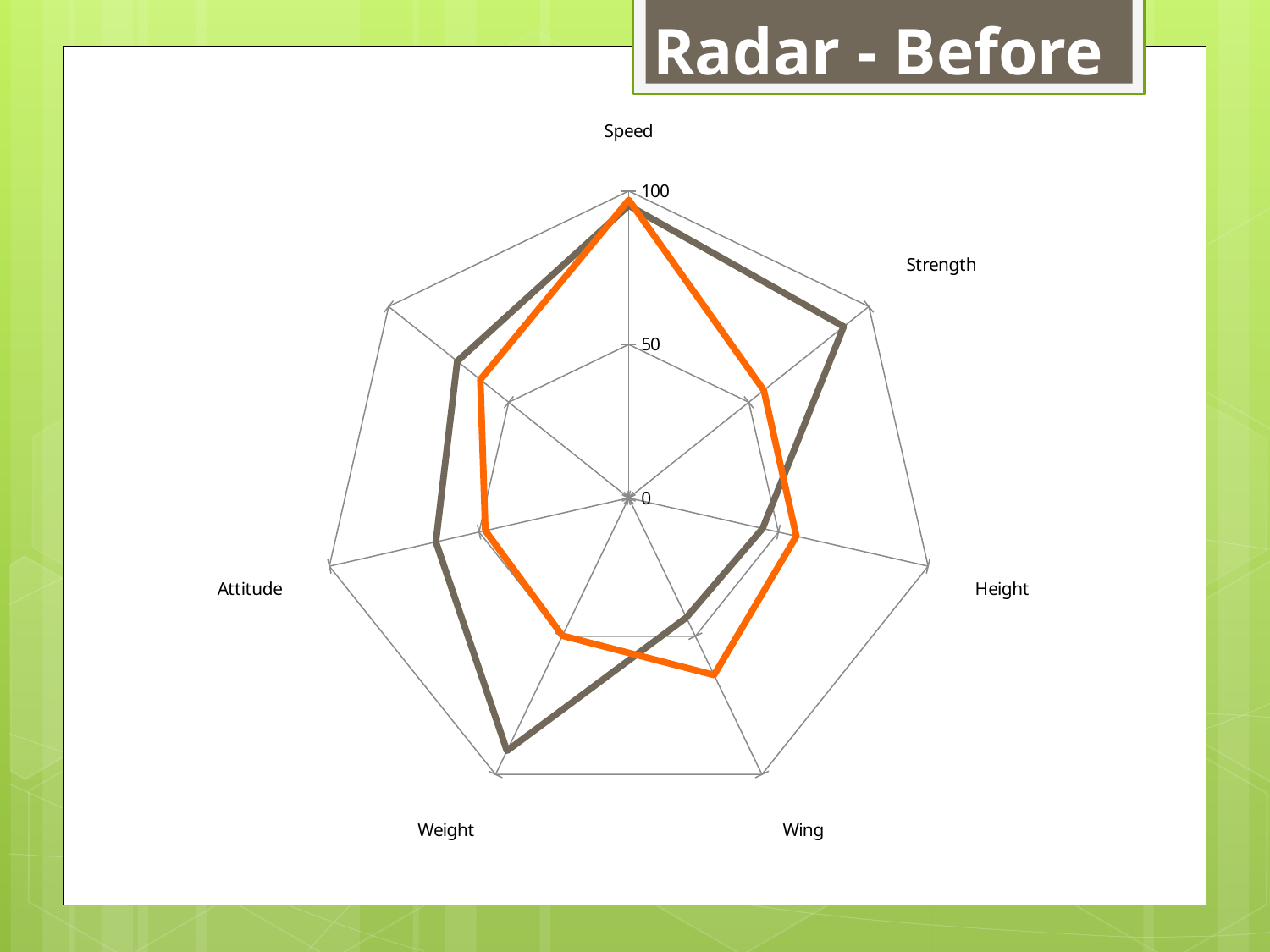
What is the title of the slide? Radar - Before Is the brown series' value for Weight greater or less than 50? greater For Strength, which series has the larger value, the brown or the orange one? brown For which category does the orange series reach its highest value? Speed What kind of chart is shown on the slide? Radar chart For Weight, which series has the larger value, the brown or the orange one? brown Is the orange series' value for Wing greater or less than 50? greater Is the brown series' value for Strength greater or less than 50? greater What is the highest value shown on the radial axis of the chart? 100 How many data series are plotted on the radar chart? 2